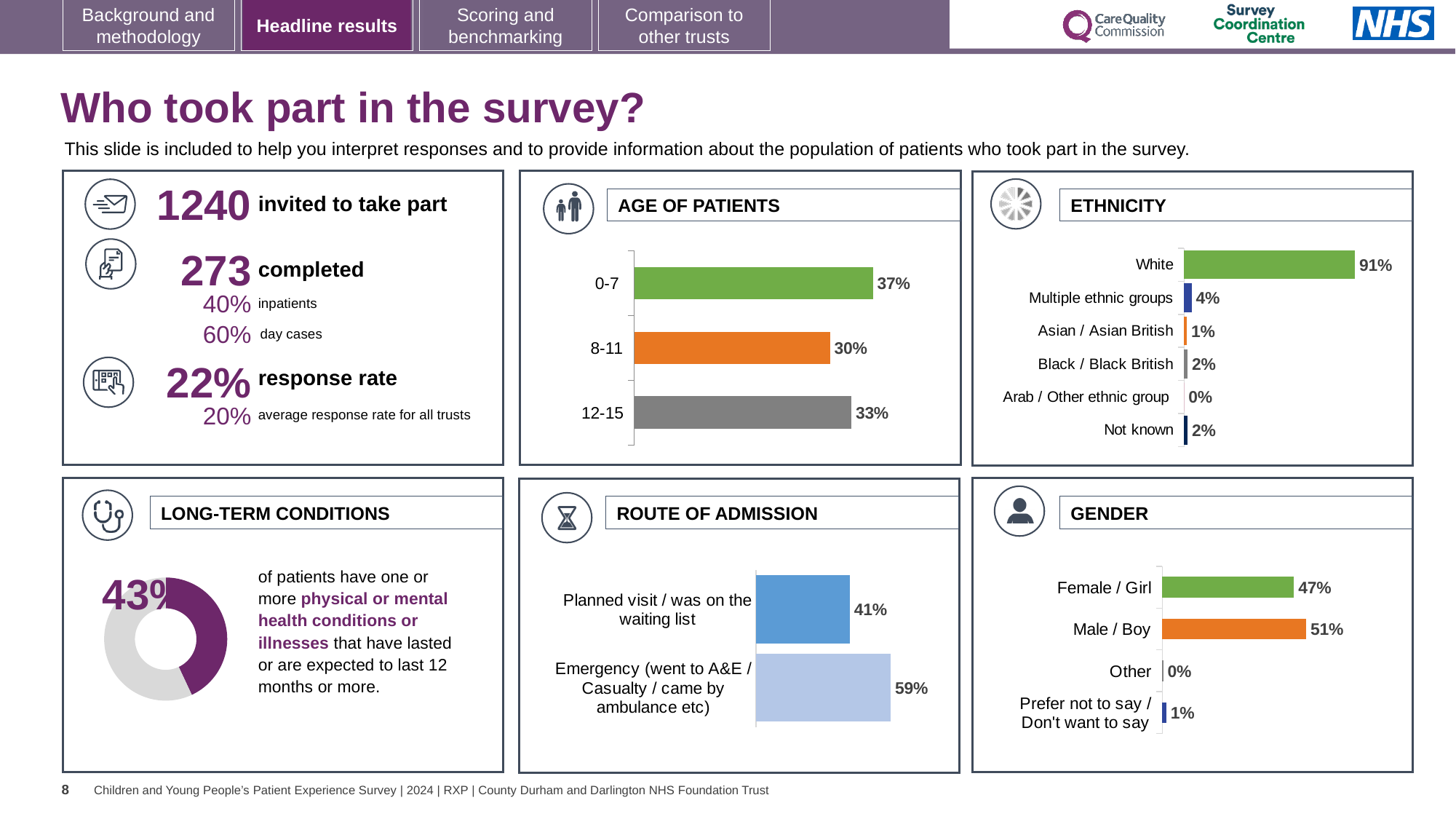
In the LONG-TERM CONDITIONS chart, what share of patients have one or more long-term conditions? 43% In the GENDER chart, what is the difference between Male / Boy and Female / Girl? 4% In the ROUTE OF ADMISSION chart, what is the value for Emergency (went to A&E / Casualty / came by ambulance etc)? 59% In the ETHNICITY chart, which category has the highest value? White What kind of chart is the LONG-TERM CONDITIONS chart? Doughnut chart In the ROUTE OF ADMISSION chart, which is larger: Planned visit / was on the waiting list or Emergency? Emergency In the ETHNICITY chart, what is the value for Multiple ethnic groups? 4% In the AGE OF PATIENTS chart, what is the difference between the 0-7 and 12-15 values? 4% In the GENDER chart, what is the value for Male / Boy? 51% How many categories does the ETHNICITY chart show? 6 In the AGE OF PATIENTS chart, which age group has the highest value? 0-7 In the AGE OF PATIENTS chart, what is the value for the 8-11 age group? 30%